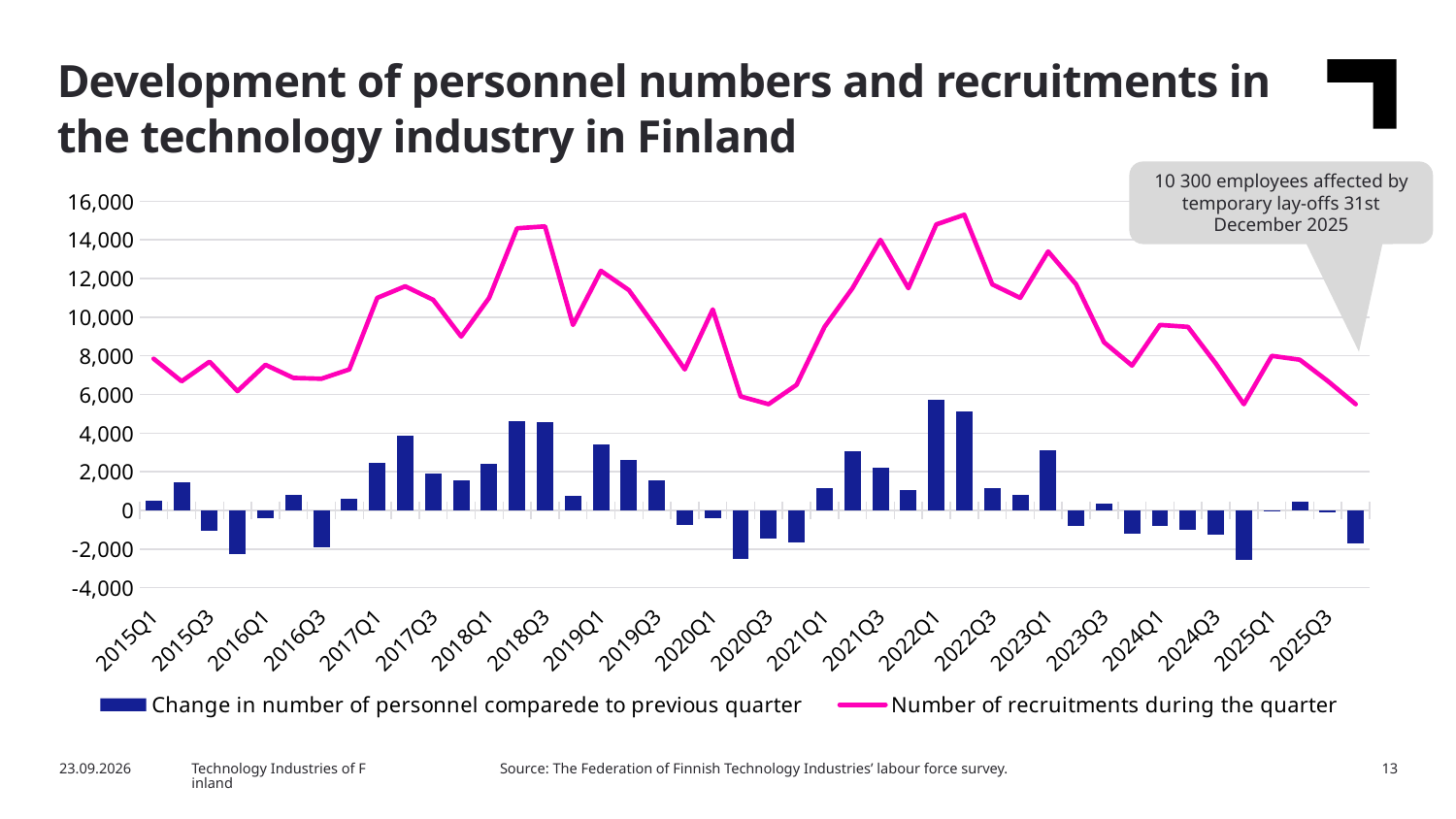
Does the number of recruitments during the quarter generally rise or fall from 2023Q1 to 2025Q3? fall Which is larger, the number of recruitments during the quarter in 2018Q3 or in 2020Q3? 2018Q3 Is the number of recruitments during the quarter in 2017Q1 greater or less than 10,000? greater How many series does the chart legend list? 2 According to the callout on the chart, how many employees were affected by temporary lay-offs on 31st December 2025? 10 300 Is the change in number of personnel compared to previous quarter in 2016Q3 greater or less than 0? less Is the number of recruitments during the quarter in 2020Q3 greater or less than 6,000? less Which quarter has the highest change in number of personnel compared to previous quarter? 2022Q1 Which series is drawn as a line in the chart? Number of recruitments during the quarter What kind of chart is shown on the slide? A combined bar and line chart